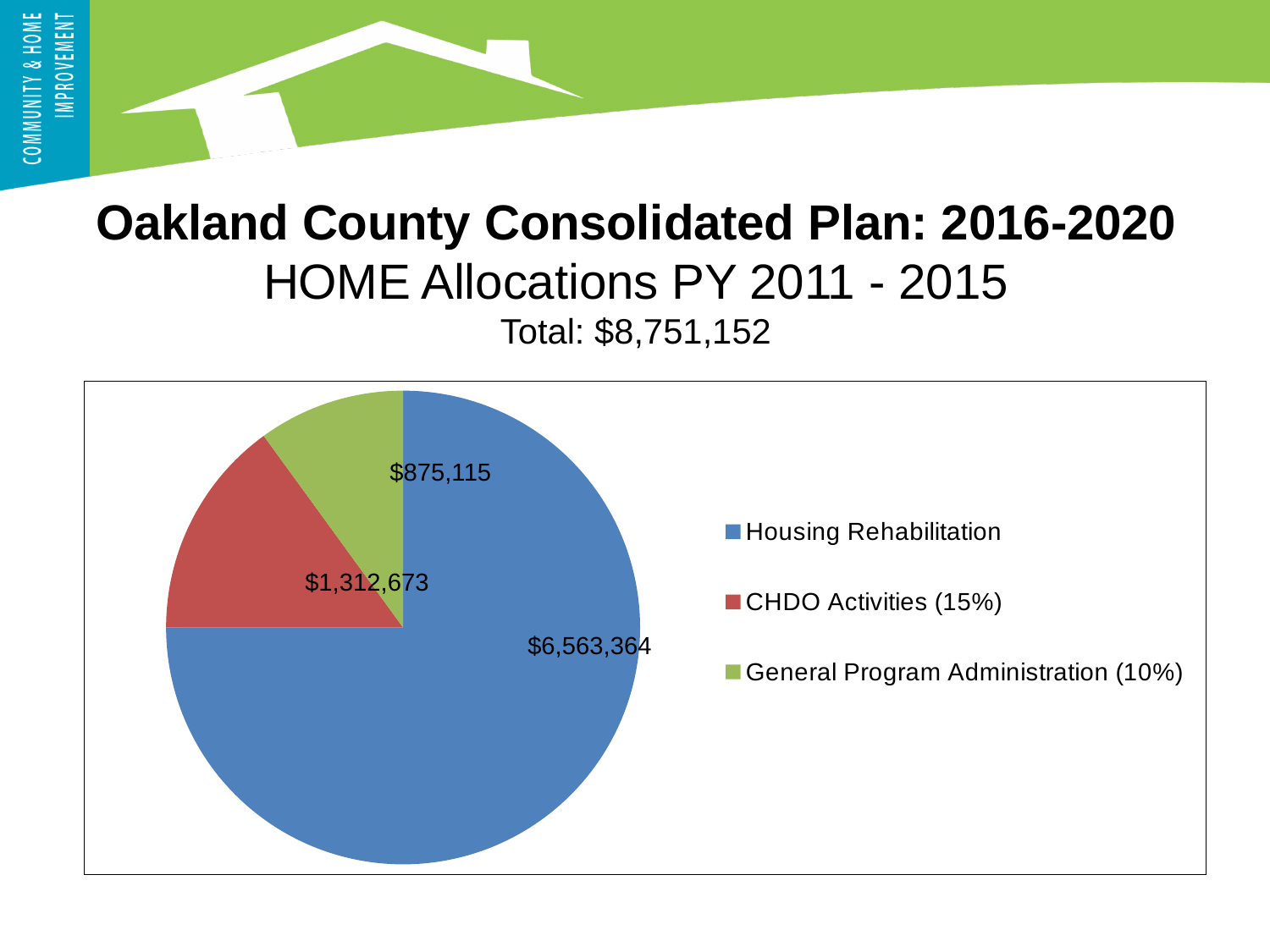
What is the total of all slices in the pie chart? $8,751,152 What is the value of the Housing Rehabilitation slice? $6,563,364 What is the value of the CHDO Activities (15%) slice? $1,312,673 Which category has the smallest slice of the pie? General Program Administration (10%) Which category has the largest slice of the pie? Housing Rehabilitation Which is larger, the CHDO Activities slice or the General Program Administration slice? CHDO Activities What share of the pie does the CHDO Activities slice represent? 15% What is the value of the General Program Administration (10%) slice? $875,115 What kind of chart is shown on the slide? Pie chart What is the difference between the Housing Rehabilitation value and the CHDO Activities value? $5,250,691 What is the difference between the CHDO Activities value and the General Program Administration value? $437,558 How many categories does the pie chart show? 3